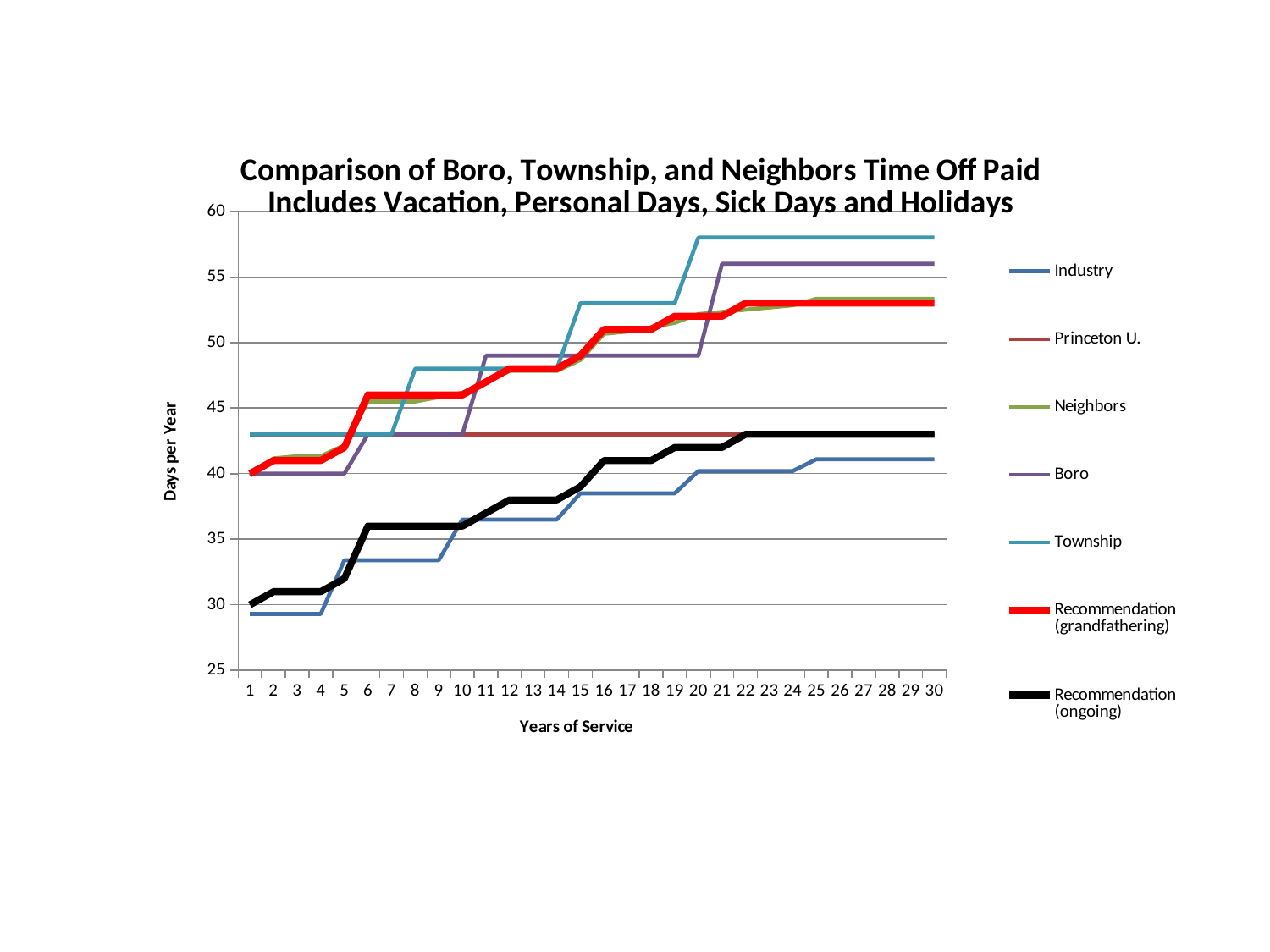
What is the value for Recommendation (grandfathering) at year 1 of service? 40 What is the value for Recommendation (ongoing) at year 1 of service? 30 Do the values for Recommendation (ongoing) rise or fall as years of service increase? rise How many series does the legend list? 7 Which series has the highest value at year 30 of service? Township How many years of service are shown along the x axis? 30 Is the value for Township at year 30 greater or less than 55? greater Is the value for Industry at year 1 greater or less than 30? less Which series has the lowest value at year 30 of service? Industry Which series is drawn in red in the legend? Recommendation (grandfathering) What kind of chart is shown on the slide? line chart Which is larger at year 30 of service, Boro or Recommendation (ongoing)? Boro